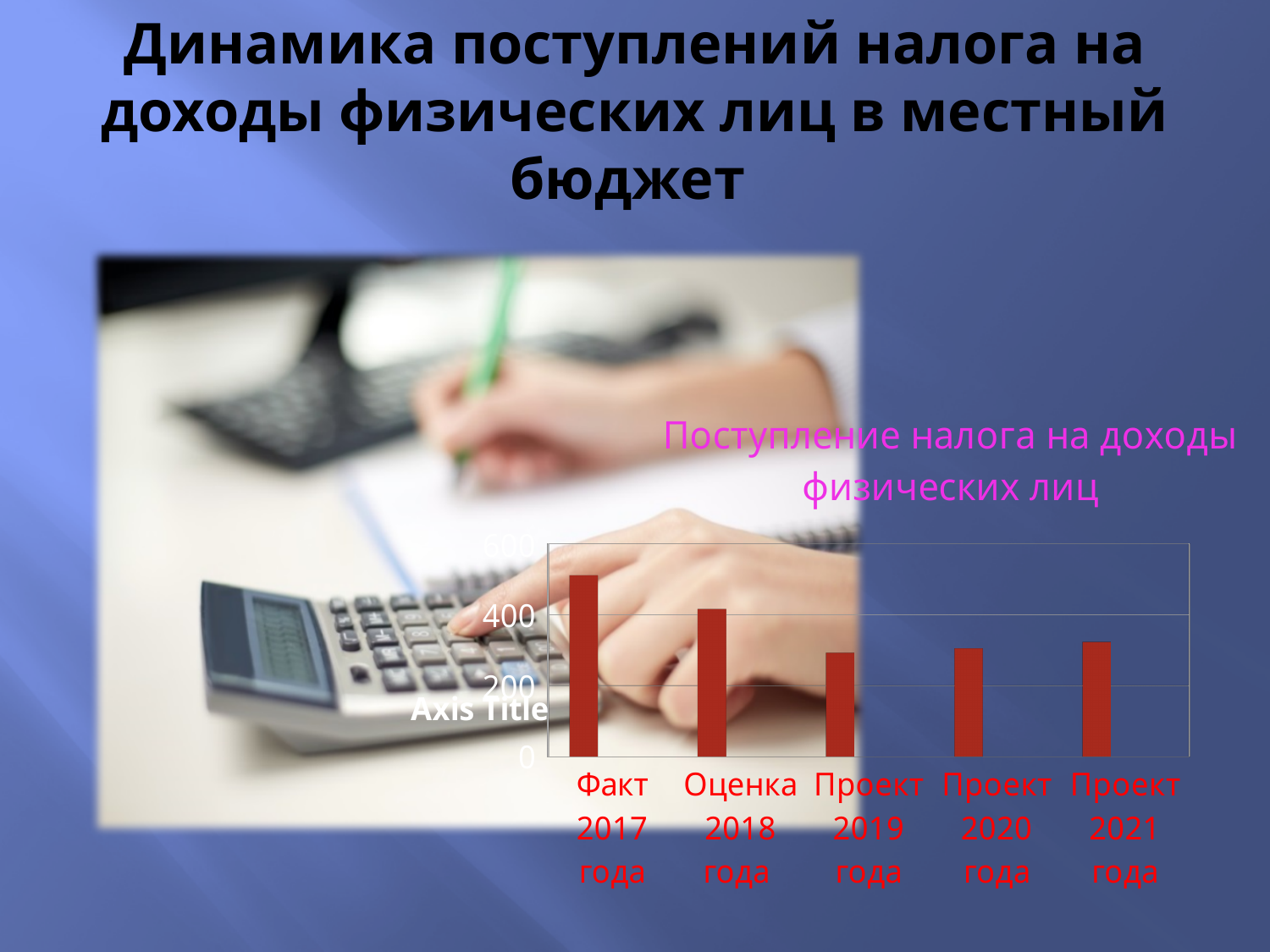
How many categories (bars) does the chart show? 5 What is the title of the chart? Поступление налога на доходы физических лиц Is the value for Проект 2019 года greater or less than 400? less Is the value for Проект 2021 года greater or less than 400? less Is the value for Проект 2020 года greater or less than 200? greater Which category has the highest value in the chart? Факт 2017 года Do the values rise or fall from Факт 2017 года to Проект 2019 года? fall Which is larger, the value for Оценка 2018 года or the value for Проект 2021 года? Оценка 2018 года What kind of chart is shown on the slide? Bar chart Which is larger, the value for Факт 2017 года or the value for Проект 2019 года? Факт 2017 года What is the label shown on the vertical axis of the chart? Axis Title